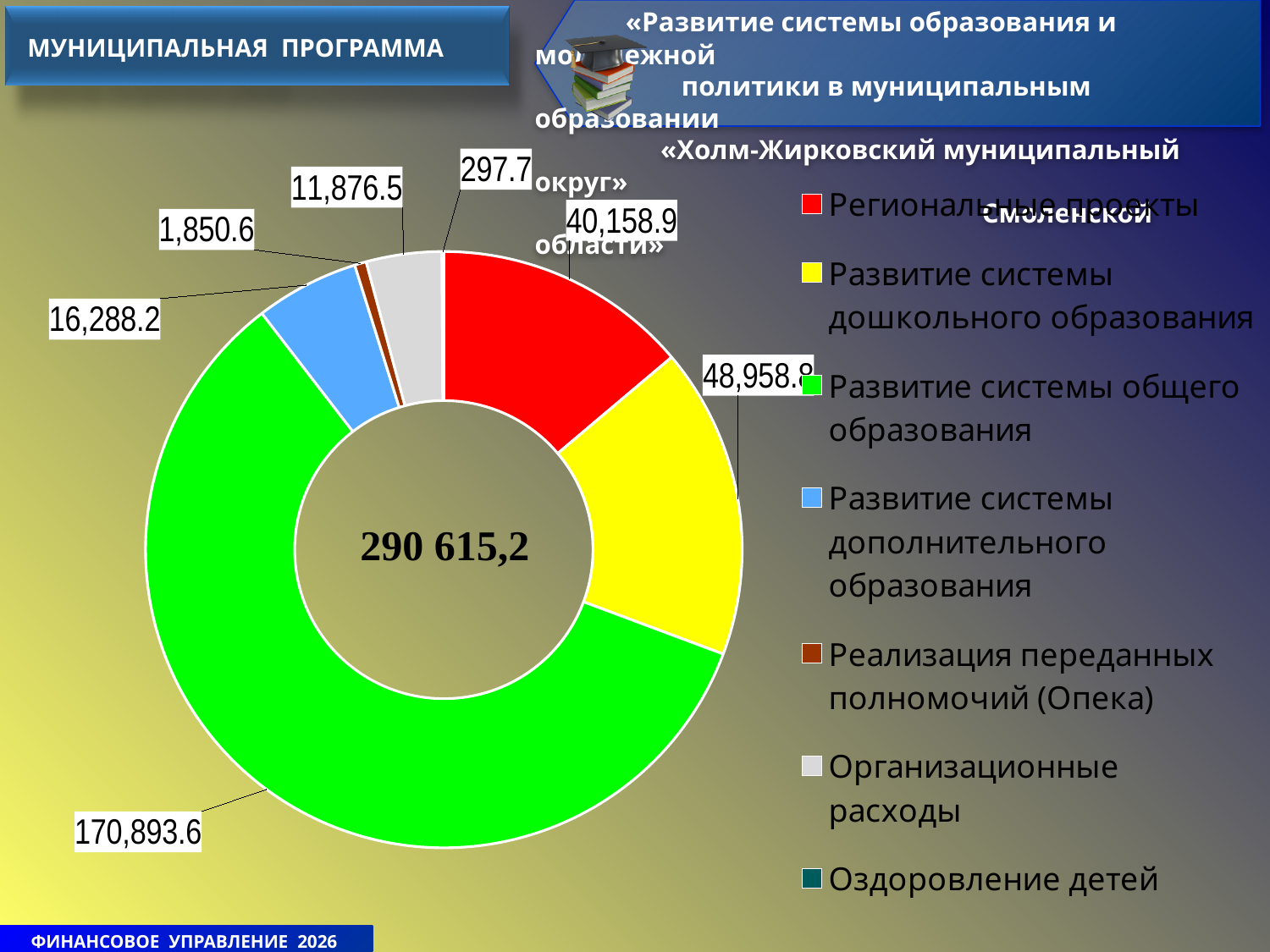
What is the value for «Региональные проекты»? 40,158.9 What is the value for «Организационные расходы»? 11,876.5 Which category has the smallest slice in the chart? Оздоровление детей What is the value for «Развитие системы дополнительного образования»? 16,288.2 What is the difference between the values for «Развитие системы дополнительного образования» and «Организационные расходы»? 4,411.7 What is the value for «Развитие системы общего образования»? 170,893.6 What kind of chart is shown on the slide? doughnut (pie) chart What is the value for «Реализация переданных полномочий (Опека)»? 1,850.6 Which category has the largest slice in the chart? Развитие системы общего образования Which is larger: «Региональные проекты» or «Развитие системы дошкольного образования»? Развитие системы дошкольного образования How many categories does the legend of the chart list? 7 What is the value for «Оздоровление детей»? 297.7